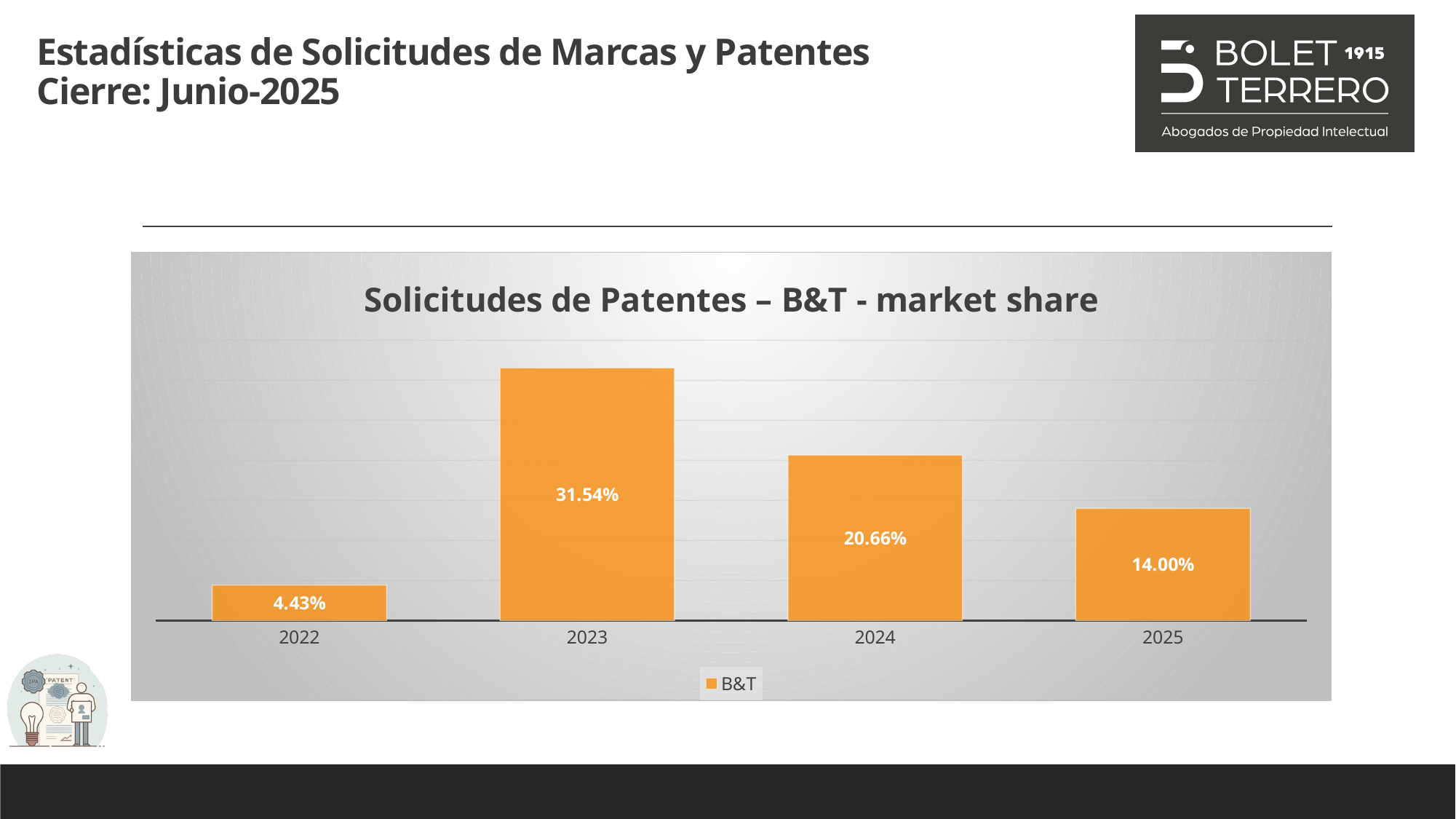
What is the B&T market share value for 2025? 14.00% What is the title of the chart? Solicitudes de Patentes – B&T - market share What is the difference between the B&T market share in 2023 and 2024? 10.88% What is the B&T market share value for 2023? 31.54% Which year has a larger B&T market share, 2024 or 2025? 2024 What kind of chart is shown on the slide? Bar chart Which year has the lowest B&T market share? 2022 Which year has the highest B&T market share? 2023 How many series does the chart legend list? 1 What is the difference between the B&T market share in 2024 and 2025? 6.66% How many years are shown on the x axis of the chart? 4 What is the B&T market share value for 2022? 4.43%